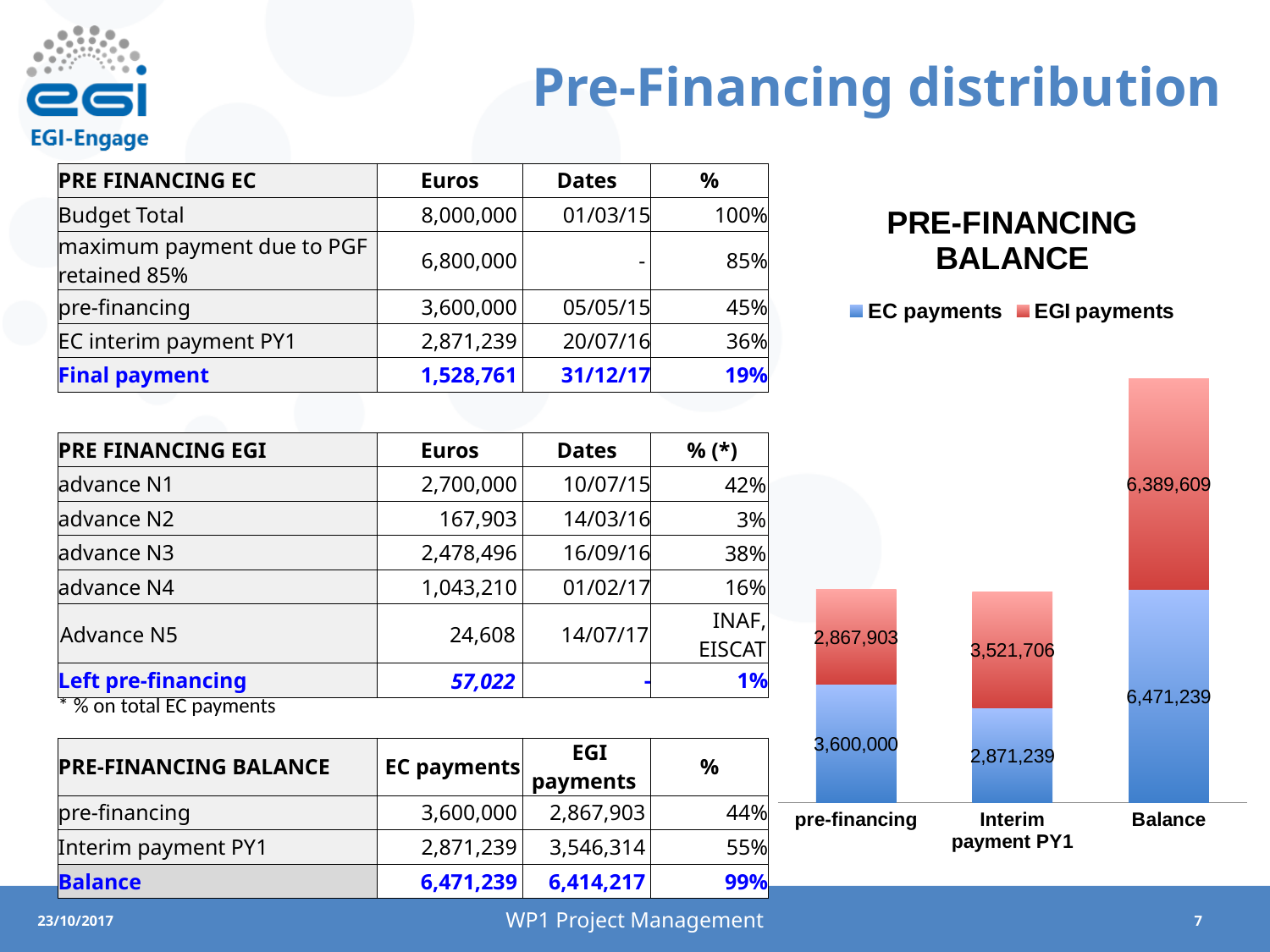
In the PRE-FINANCING BALANCE chart, what is the EGI payments value for Interim payment PY1? 3,521,706 In the PRE-FINANCING BALANCE chart, which category has the highest EC payments value? Balance In the PRE-FINANCING BALANCE chart, what is the EGI payments value for Balance? 6,389,609 In the PRE-FINANCING BALANCE chart, what is the difference between the EC payments for pre-financing and for Interim payment PY1? 728,761 How many categories are shown on the x axis of the PRE-FINANCING BALANCE chart? 3 In the PRE-FINANCING BALANCE chart, which colour represents EGI payments? Red In the PRE-FINANCING BALANCE chart, which category has the lowest EC payments value? Interim payment PY1 In the PRE-FINANCING BALANCE chart, what is the EC payments value for pre-financing? 3,600,000 In the PRE-FINANCING BALANCE chart, for pre-financing, which is larger: EC payments or EGI payments? EC payments What type of chart is the PRE-FINANCING BALANCE chart? Stacked bar chart How many series does the legend of the PRE-FINANCING BALANCE chart list? 2 In the PRE-FINANCING BALANCE chart, what is the total of the stacked bar for Interim payment PY1? 6,392,945